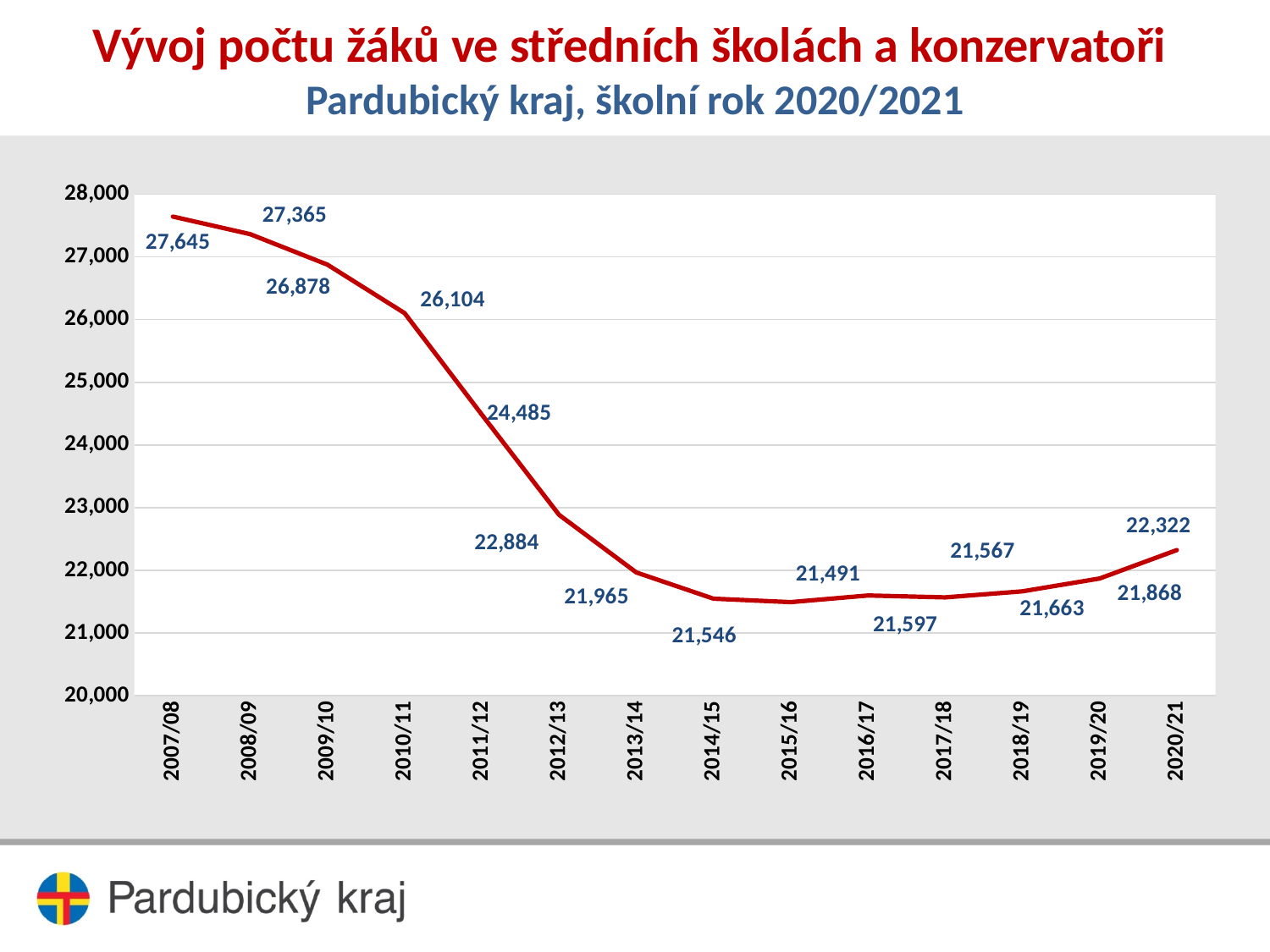
What is the number of pupils for the school year 2007/08? 27,645 What is the value plotted for 2015/16? 21,491 What is the difference between the values for 2007/08 and 2020/21? 5,323 Does the value rise or fall from 2007/08 to 2014/15? fall What is the subtitle of the chart below the main title? Pardubický kraj, školní rok 2020/2021 Which school year has the highest value? 2007/08 How many school years are plotted on the x axis? 14 Which school year has the lowest value? 2015/16 What type of chart is shown on the slide? line chart What is the value plotted for 2011/12? 24,485 Which is larger, the value for 2012/13 or the value for 2019/20? 2012/13 What is the value plotted for 2020/21? 22,322